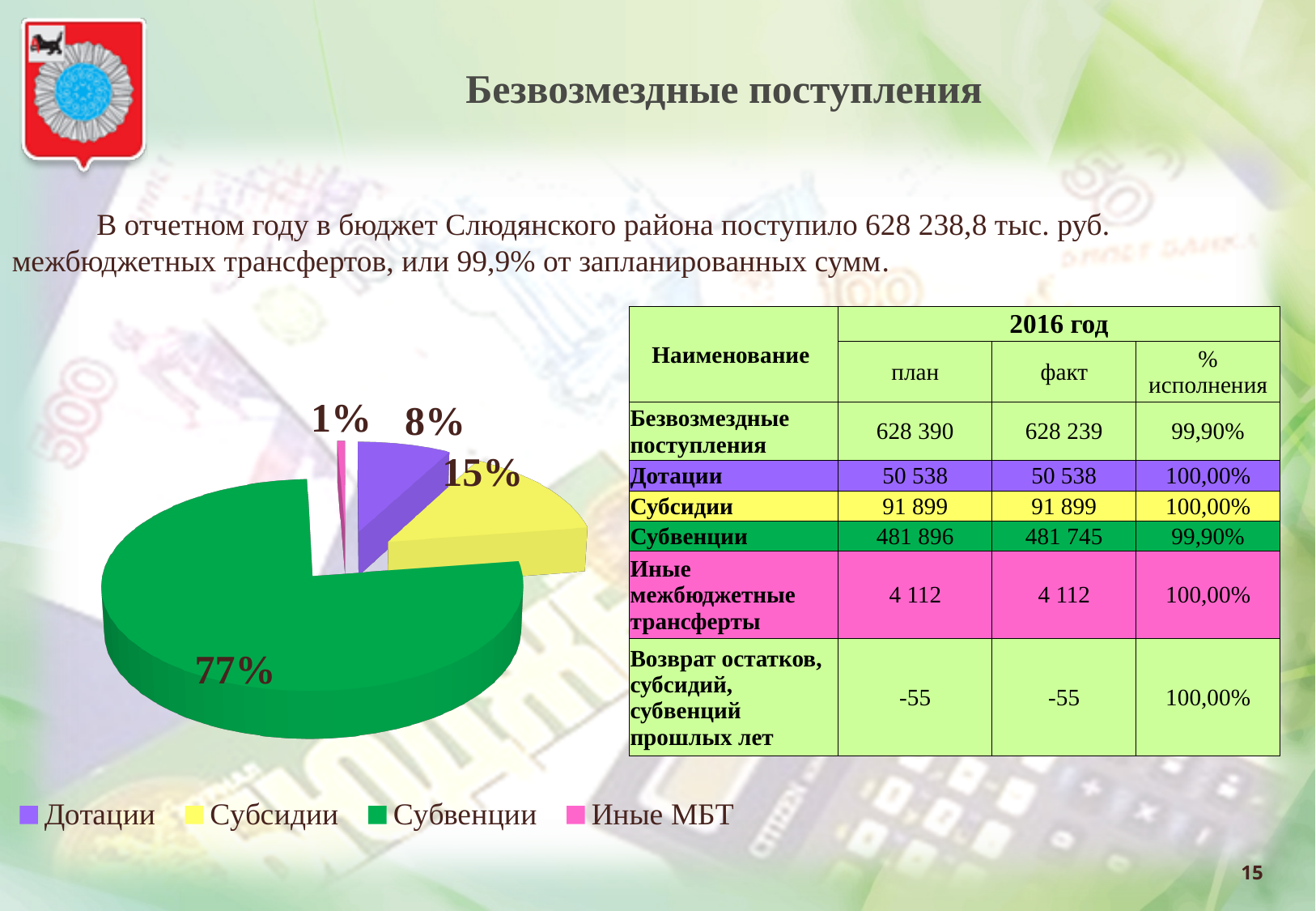
How many entries does the legend list? 4 Which category has the smallest slice of the pie? Иные МБТ Which category has the largest slice of the pie? Субвенции What share of the pie does Субвенции have? 77% What is the difference in percentage points between the Субсидии slice and the Дотации slice? 7 Which slice is larger, Субсидии or Дотации? Субсидии What colour is the Субвенции slice in the pie chart? Green What share of the pie does Иные МБТ have? 1% What kind of chart is shown on the slide? Pie chart What share of the pie does Субсидии have? 15% What share of the pie does Дотации have? 8% How many slices does the pie chart have? 4